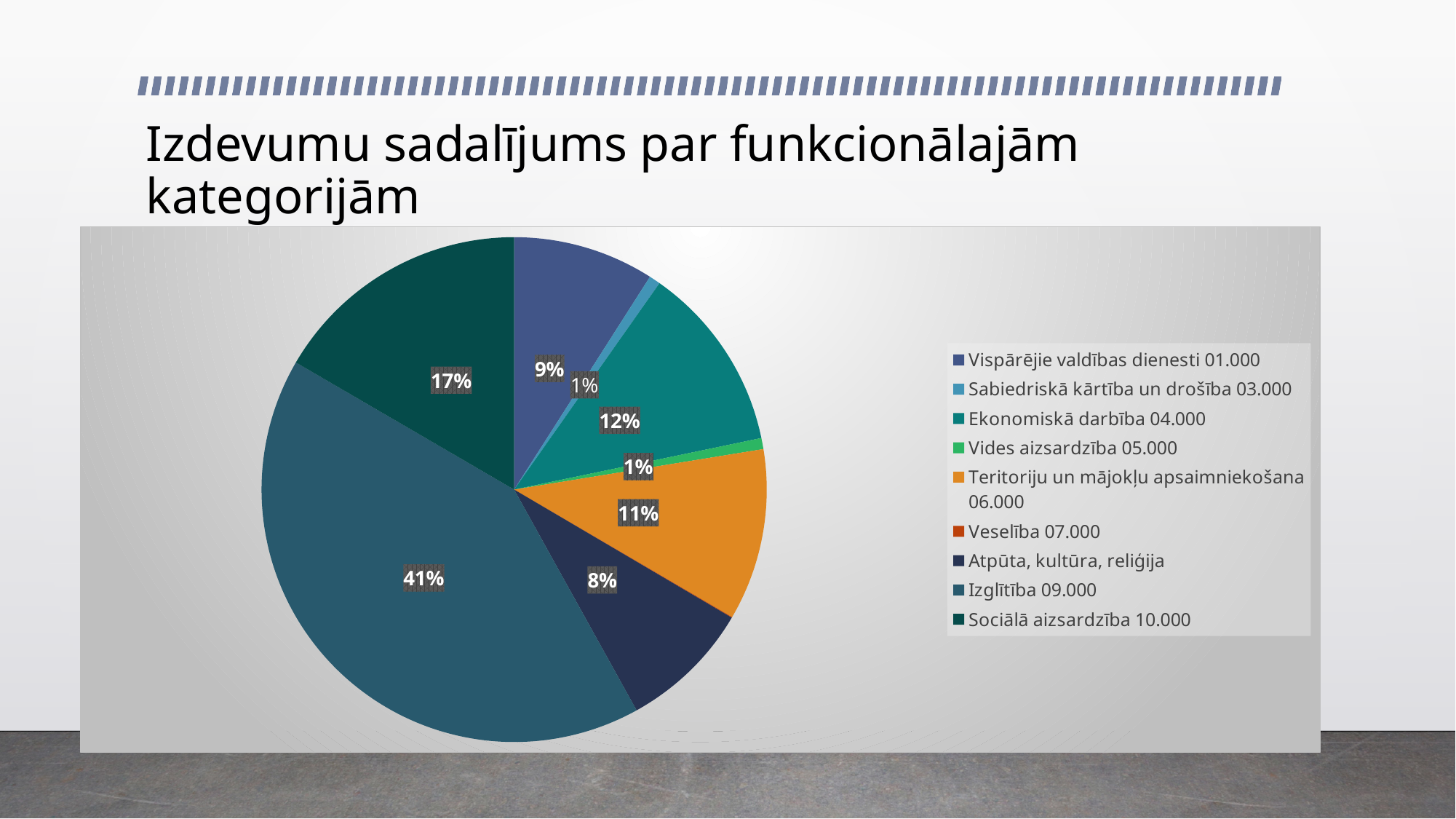
What is the value for Atpūta, kultūra, reliģija? 8% What is the value for Vispārējie valdības dienesti 01.000? 9% Which is larger, the share for Ekonomiskā darbība 04.000 or for Teritoriju un mājokļu apsaimniekošana 06.000? Ekonomiskā darbība 04.000 What is the value for Ekonomiskā darbība 04.000? 12% What is the title of the slide containing the chart? Izdevumu sadalījums par funkcionālajām kategorijām What kind of chart is shown on the slide? pie chart What is the value for Sociālā aizsardzība 10.000? 17% What is the difference in percentage points between Izglītība 09.000 and Sociālā aizsardzība 10.000? 24 What share of expenditure goes to Izglītība 09.000? 41% How many categories does the legend list? 9 Which category has the largest share of the pie? Izglītība 09.000 What is the value for Teritoriju un mājokļu apsaimniekošana 06.000? 11%